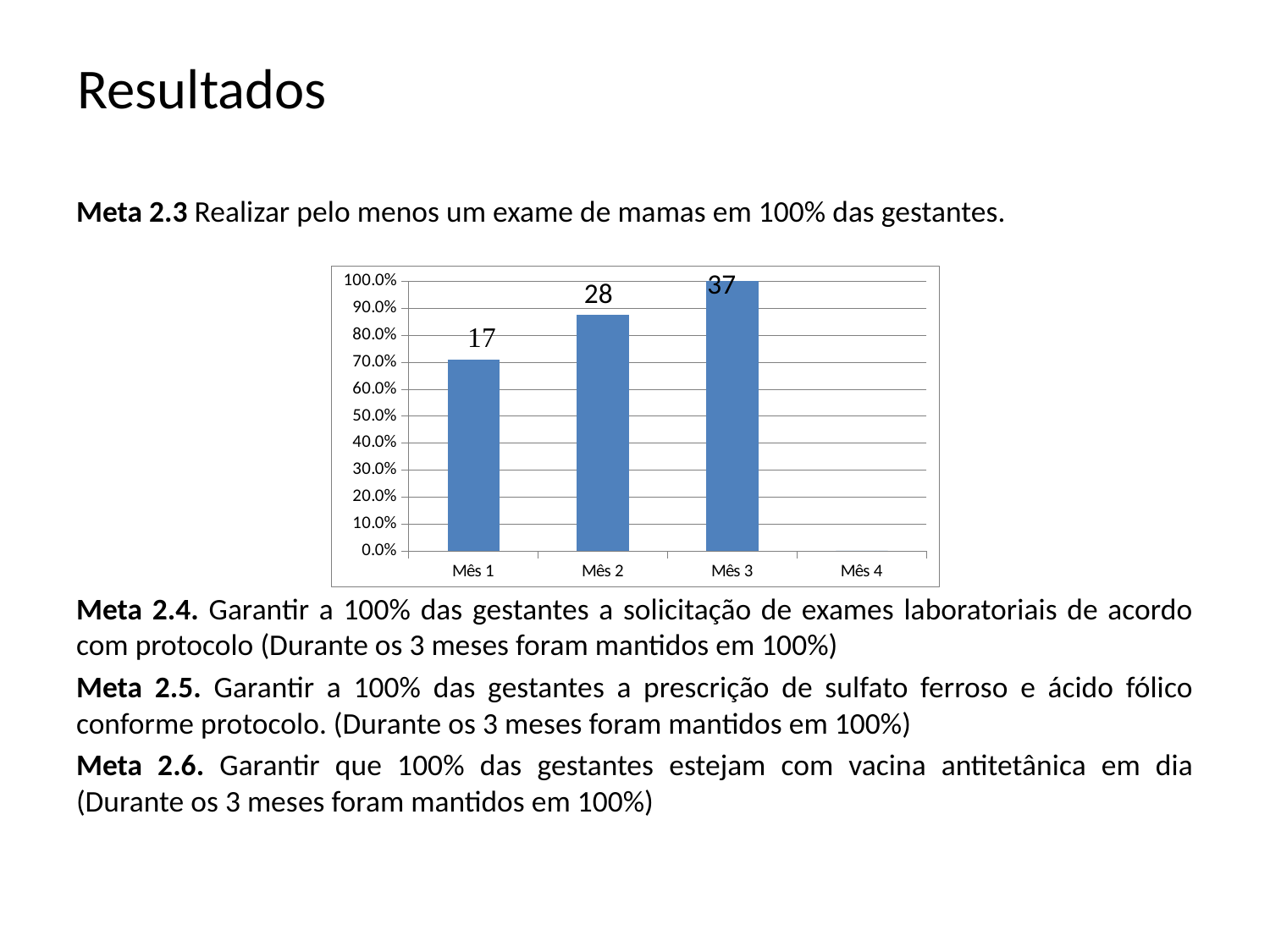
What is the difference between the data labels for Mês 3 and Mês 1? 20 Is the value for Mês 1 greater or less than 80.0%? less What data label is shown on the bar for Mês 3? 37 Is the value for Mês 2 greater or less than 80.0%? greater What kind of chart is shown on the slide? bar chart What data label is shown on the bar for Mês 2? 28 Which month has the tallest bar? Mês 3 How many categories are shown on the x axis? 4 Do the bar values rise or fall from Mês 1 to Mês 3? rise What data label is shown on the bar for Mês 1? 17 What percentage does the bar for Mês 3 reach on the y axis? 100.0% Among the months with a bar, which has the shortest bar? Mês 1